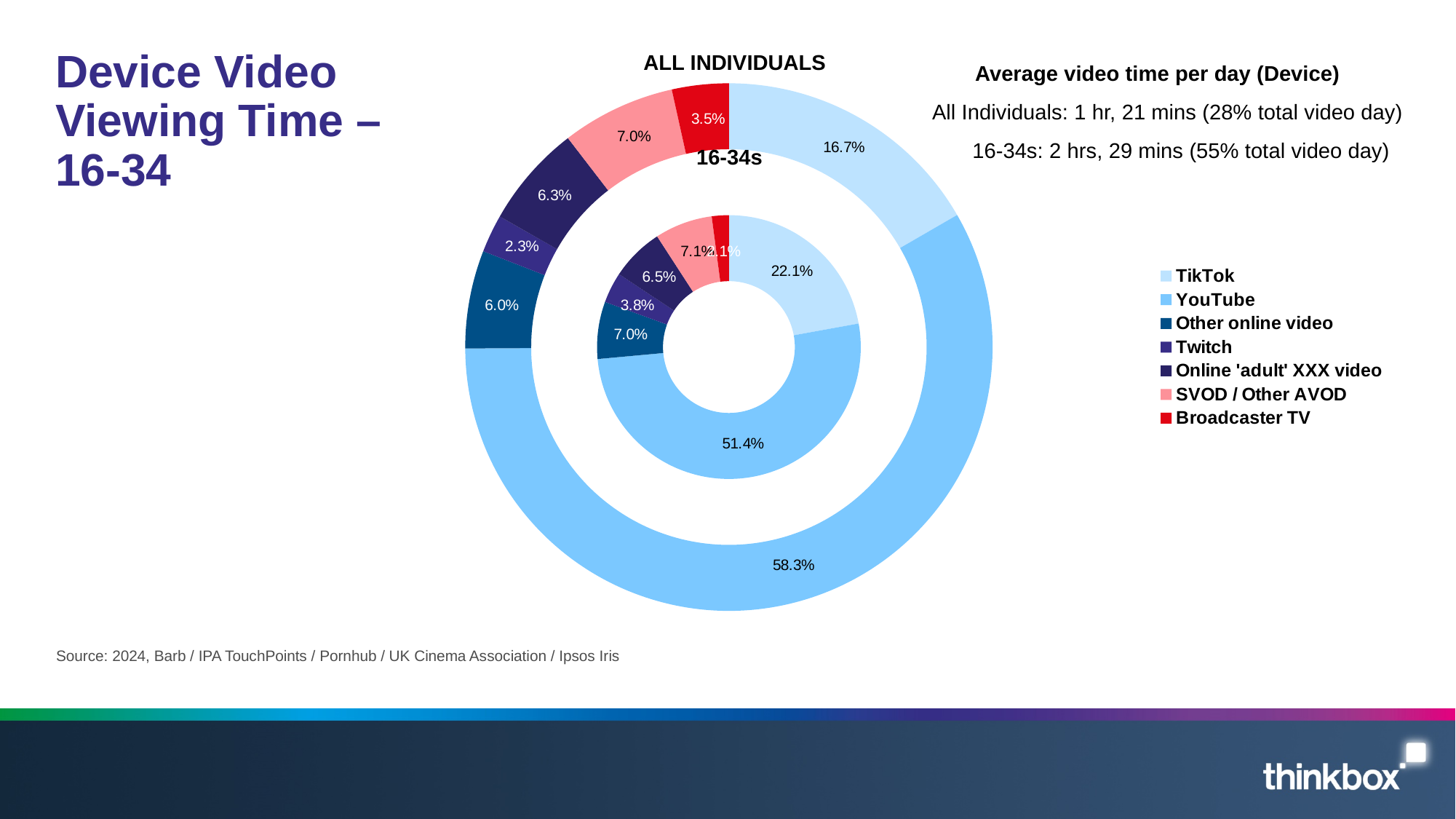
What is the Broadcaster TV share for all individuals in the outer ring? 3.5% Is the TikTok share larger for all individuals or for 16-34s? 16-34s How many percentage points higher is the YouTube share for all individuals (58.3%) than for 16-34s (51.4%)? 6.9 percentage points What share of device video viewing time does YouTube account for among all individuals (outer ring)? 58.3% What is the SVOD / Other AVOD share for 16-34s in the inner ring? 7.1% Which category has the largest share in the all individuals (outer) ring? YouTube Which category has the smallest share in the all individuals (outer) ring? Twitch What is the Twitch share for all individuals in the outer ring? 2.3% How many categories does the legend list? 7 What kind of chart is shown on the slide? Doughnut chart What share of device video viewing time does TikTok account for among 16-34s (inner ring)? 22.1% Which audience group does the outer ring of the chart represent? All individuals